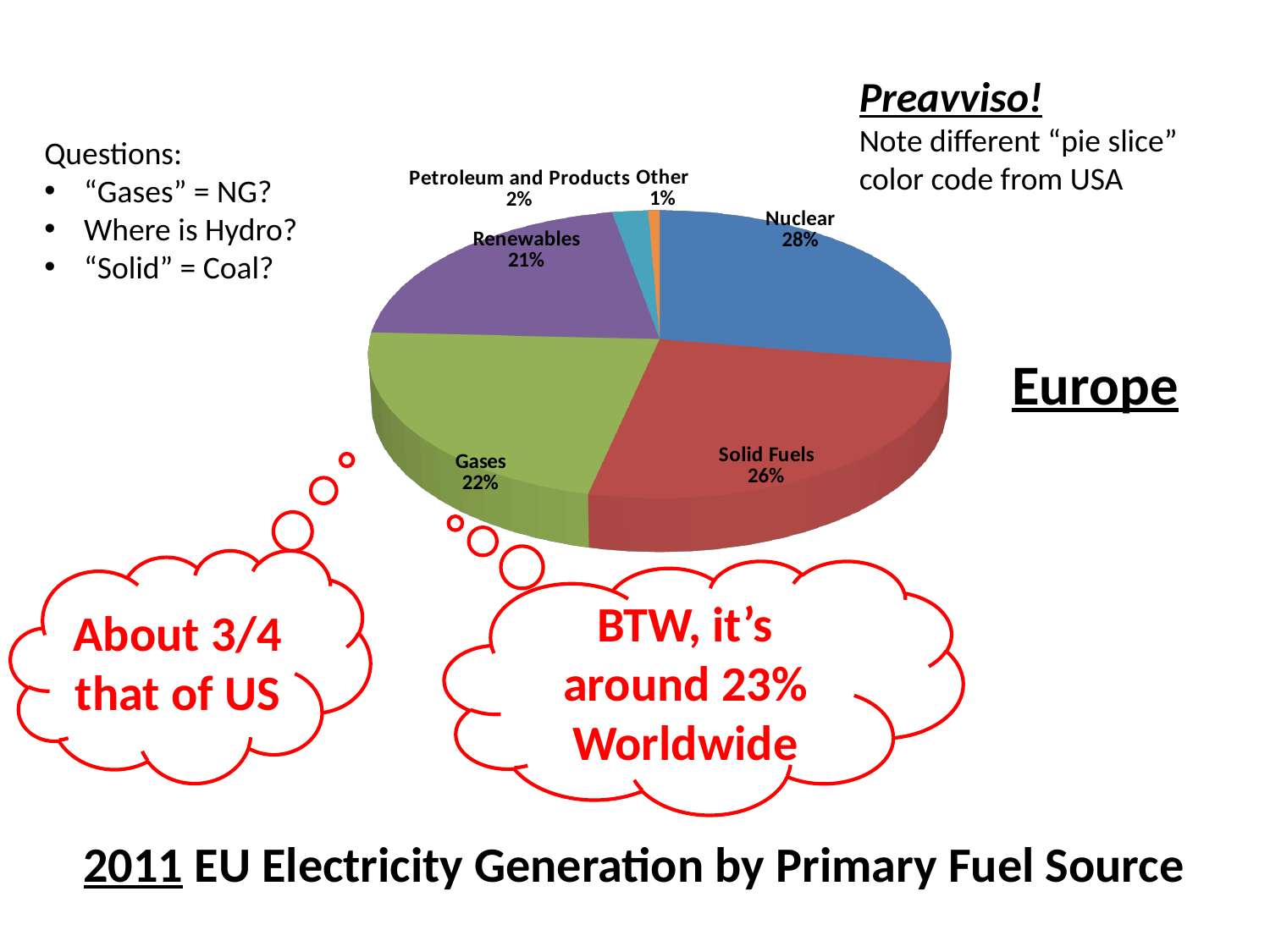
Which fuel source has the largest slice of the pie? Nuclear How many slices does the pie chart have? 6 What share is labelled for Petroleum and Products? 2% Which fuel source has the smallest slice of the pie? Other What share of EU electricity generation comes from Nuclear? 28% What colour is the Renewables slice? Purple Which is larger, the Solid Fuels slice or the Gases slice? Solid Fuels What share does Gases have in the pie chart? 22% What percentage is shown for Renewables? 21% How many percentage points larger is Nuclear than Renewables? 7 What type of chart is shown on the slide? Pie chart What percentage of the pie is Solid Fuels? 26%